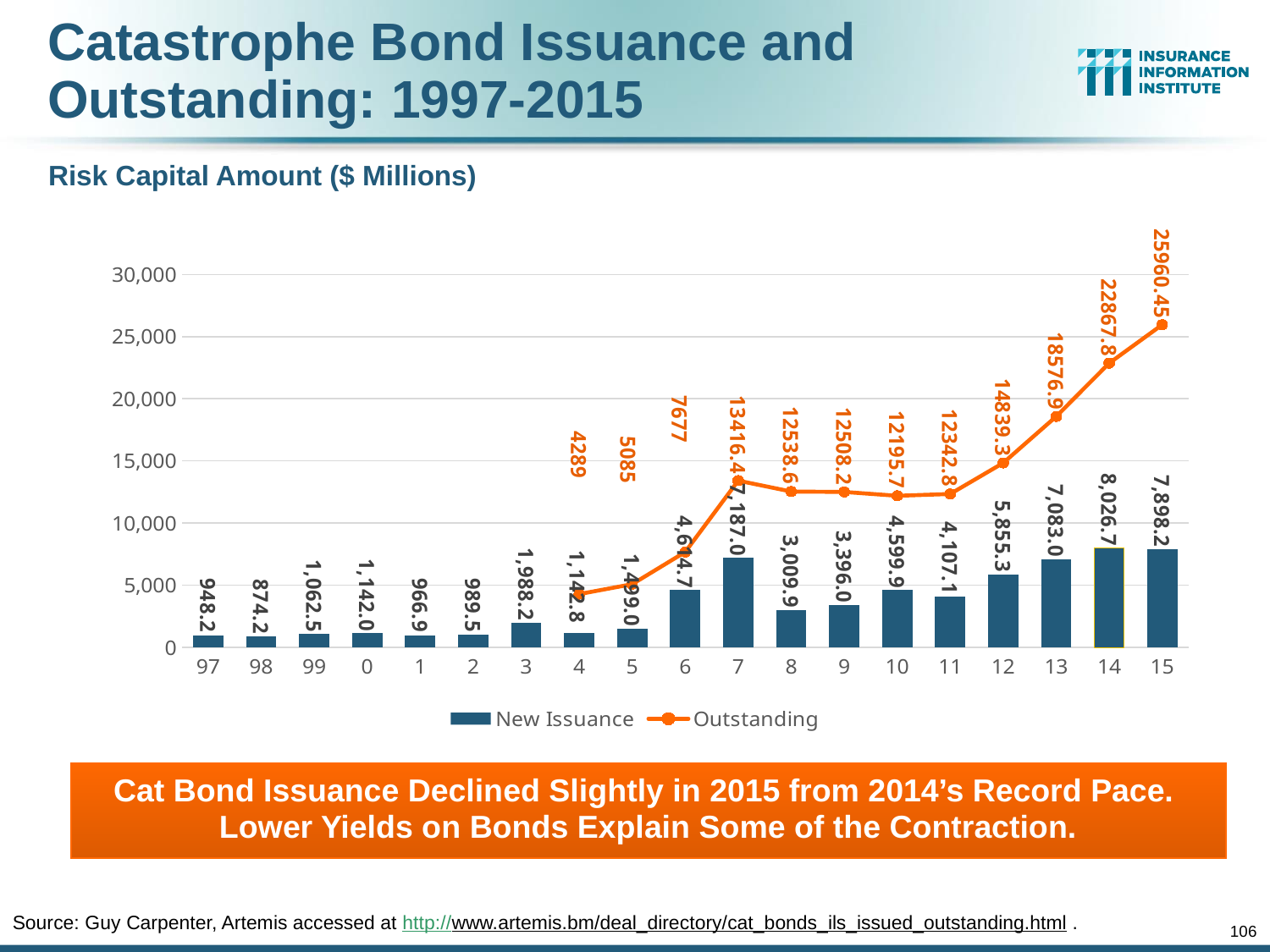
What is the New Issuance value for 14? 8,026.7 How many series does the legend list? 2 Is the Outstanding value for 13 greater or less than 15,000? greater Which year has the highest New Issuance value? 14 How many years are shown on the x axis? 19 What is the New Issuance value for 7? 7,187.0 Which year has the lowest New Issuance value? 98 What is the Outstanding value for 15? 25960.45 What kind of chart is this? Combined bar and line chart What is the difference between the New Issuance values for 14 and 15? 128.5 Which is larger, the Outstanding value for 7 or for 8? 7 Does the Outstanding line rise or fall from 12 to 15? rise